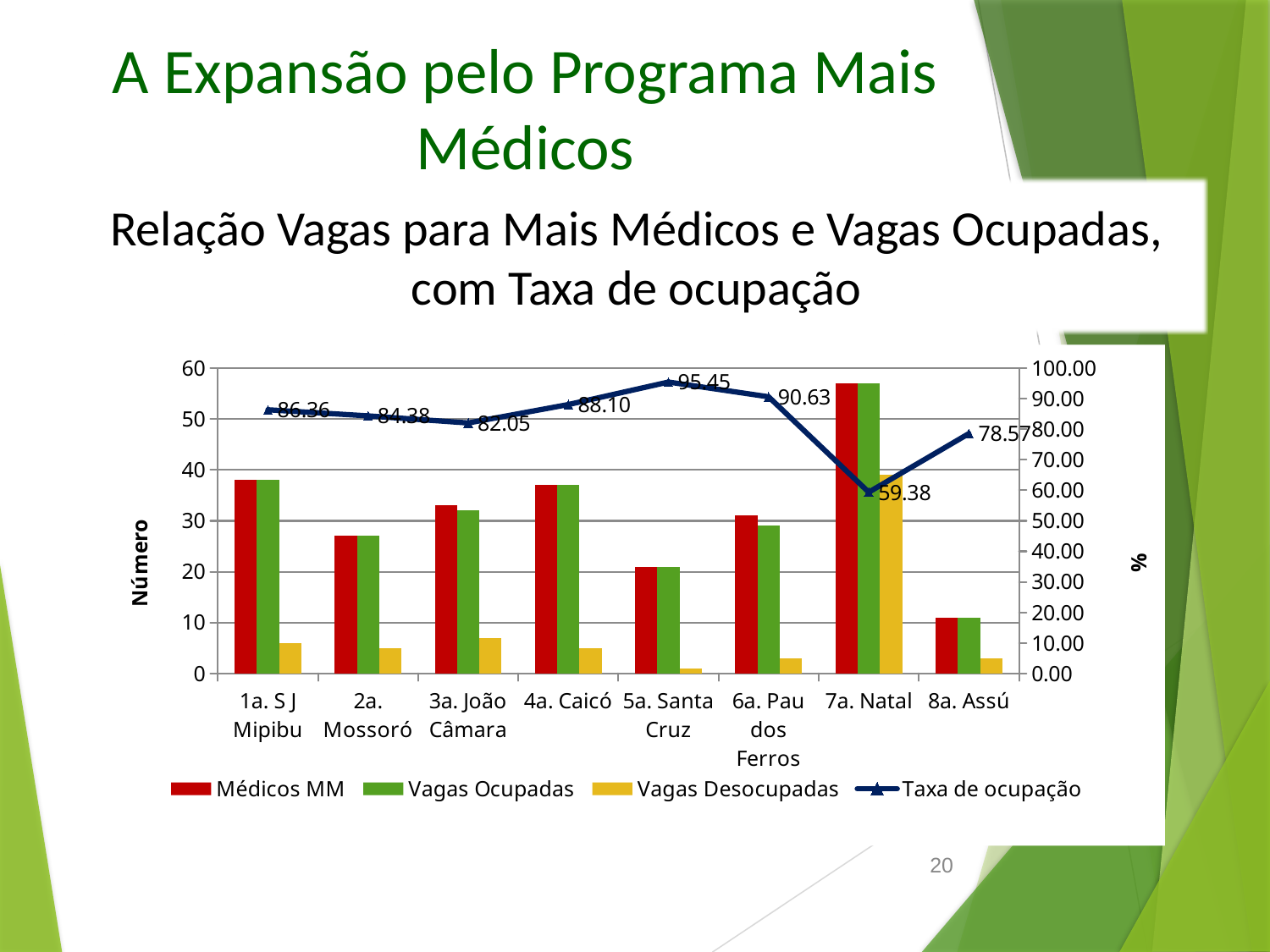
What is the difference between the Taxa de ocupação for 5a. Santa Cruz and 7a. Natal? 36.07 What is the Taxa de ocupação value for 5a. Santa Cruz? 95.45 Is the Médicos MM value for 8a. Assú greater or less than 20? less Which category has the highest Taxa de ocupação? 5a. Santa Cruz What is the Taxa de ocupação value for 1a. S J Mipibu? 86.36 Is the Médicos MM value for 7a. Natal greater or less than 50? greater What is the Taxa de ocupação value for 7a. Natal? 59.38 How many series does the legend list? 4 How many categories are shown on the x axis? 8 Which category has the lowest Taxa de ocupação? 7a. Natal Which category has the highest Médicos MM bar? 7a. Natal Which has a higher Taxa de ocupação, 1a. S J Mipibu or 2a. Mossoró? 1a. S J Mipibu